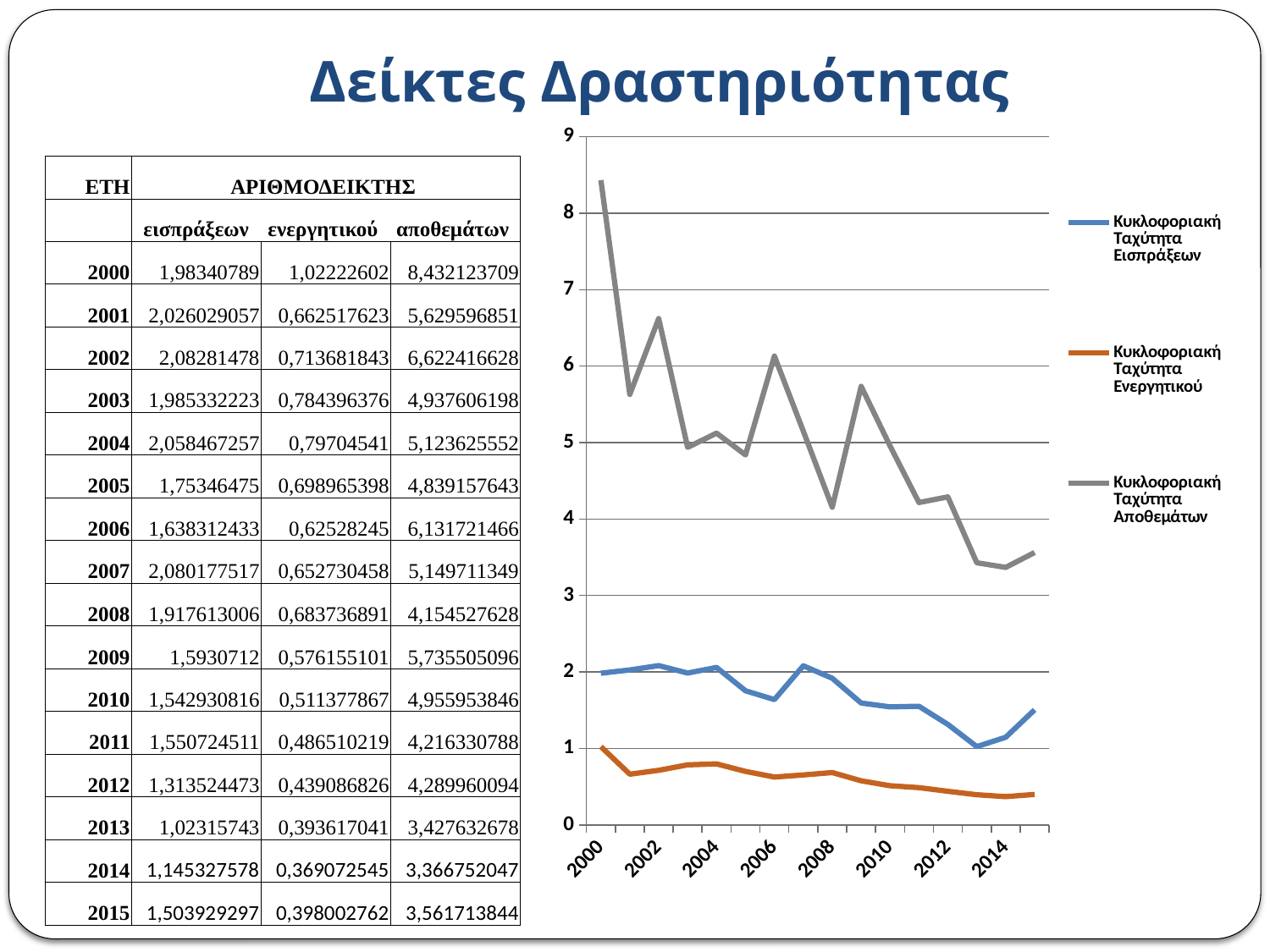
Is the value of Κυκλοφοριακή Ταχύτητα Αποθεμάτων in 2000 greater or less than 8? greater According to the table, what is the εισπράξεων ratio for 2000? 1,98340789 Which series has the highest values throughout the chart? Κυκλοφοριακή Ταχύτητα Αποθεμάτων Does the Κυκλοφοριακή Ταχύτητα Ενεργητικού line generally rise or fall from 2000 to 2015? fall How many years are plotted along the x axis of the chart? 16 How many series does the chart legend list? 3 In which year is the αποθεμάτων ratio lowest? 2014 Is the value of Κυκλοφοριακή Ταχύτητα Εισπράξεων in 2013 greater or less than 2? less According to the table, what is the αποθεμάτων ratio for 2015? 3,561713844 Which year has the larger Κυκλοφοριακή Ταχύτητα Αποθεμάτων value, 2001 or 2002? 2002 What is the title of the slide? Δείκτες Δραστηριότητας What kind of chart is shown on the slide? line chart